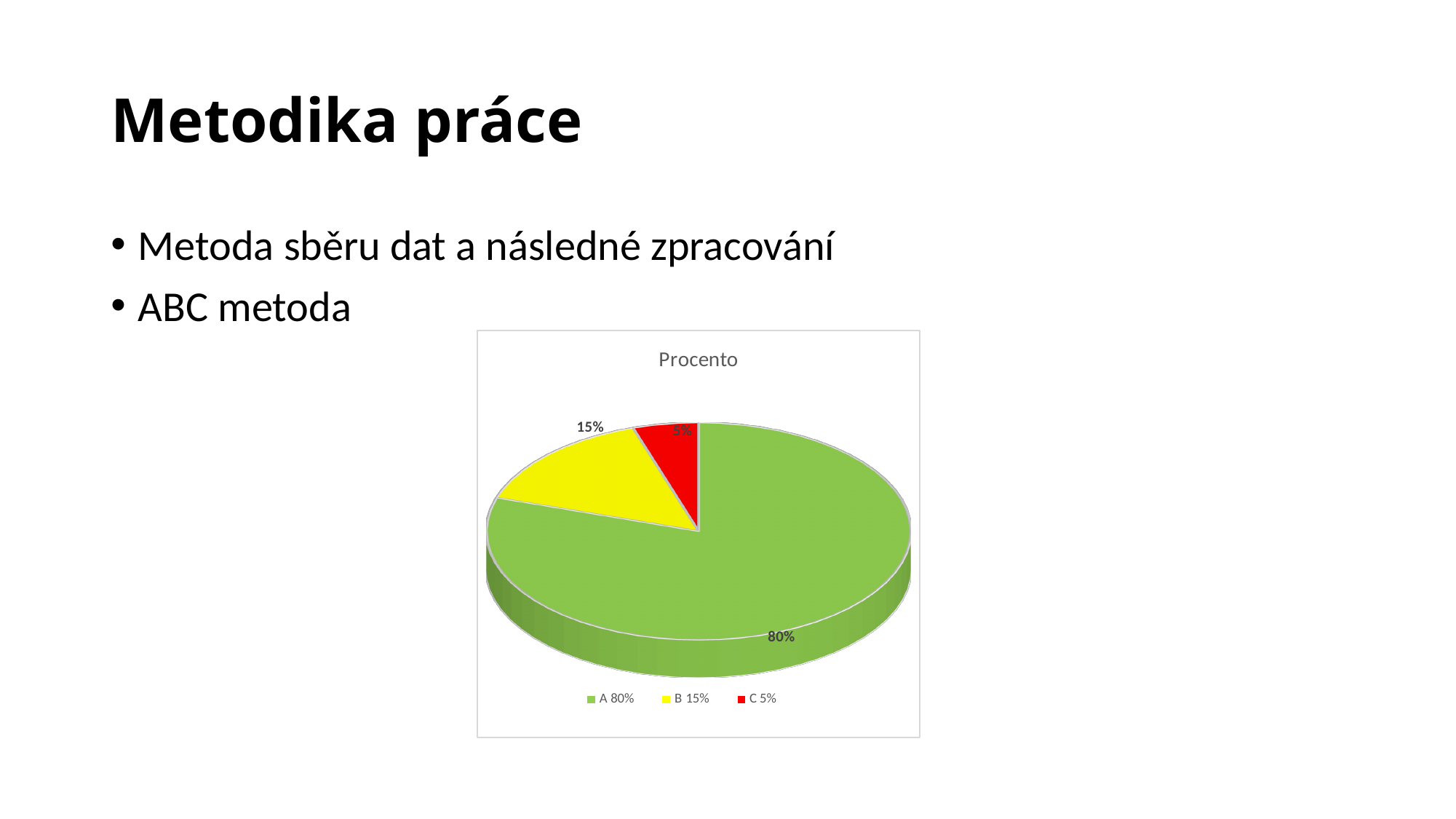
What is the title of the chart? Procento Which category has the largest slice of the pie? A 80% Which category has the smallest slice of the pie? C 5% How many slices does the pie chart have? 3 What kind of chart is shown on the slide? pie chart What share of the pie does category A 80% take? 80% What is the difference in percentage points between the B slice and the C slice? 10 Which slice is larger, B 15% or C 5%? B 15% What colour is the slice for category C 5%? red What share of the pie does category C 5% take? 5% What share of the pie does category B 15% take? 15% What is the difference in percentage points between the A slice and the B slice? 65